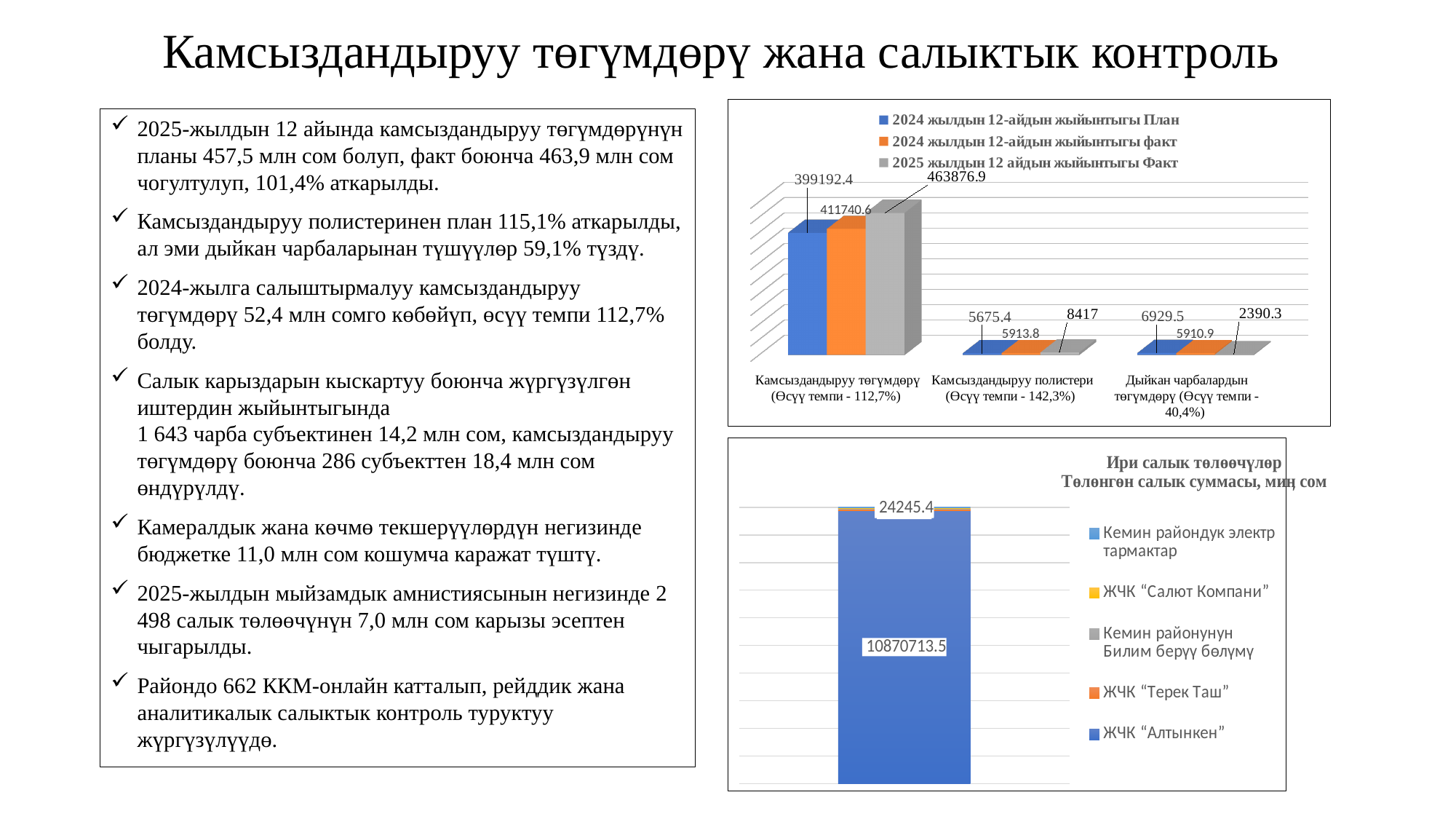
In the top chart, what is the value of the 2024 жылдын 12-айдын жыйынтыгы План series for Камсыздандыруу полистери? 5675.4 In the top chart, what is the value of the 2025 жылдын 12 айдын жыйынтыгы Факт series for Дыйкан чарбалардын төгүмдөрү? 2390.3 In the bottom chart, what is the value labelled for ЖЧК “Алтынкен”? 10870713.5 How many series does the legend of the top chart list? 3 How many entries does the legend of the bottom chart list? 5 In the top chart, for Дыйкан чарбалардын төгүмдөрү, which is larger: the 2024 План value or the 2025 Факт value? 2024 План (6929.5) How many categories are shown on the x axis of the top chart? 3 In the top chart, what is the value of the 2024 жылдын 12-айдын жыйынтыгы факт series for Дыйкан чарбалардын төгүмдөрү? 5910.9 In the top chart, what is the value of the 2025 жылдын 12 айдын жыйынтыгы Факт series for Камсыздандыруу төгүмдөрү? 463876.9 What type of chart is the top chart? Bar chart In the top chart, what is the difference between the 2025 Факт and 2024 факт values for Камсыздандыруу төгүмдөрү? 52136.3 In the top chart, which category has the highest values across all series? Камсыздандыруу төгүмдөрү